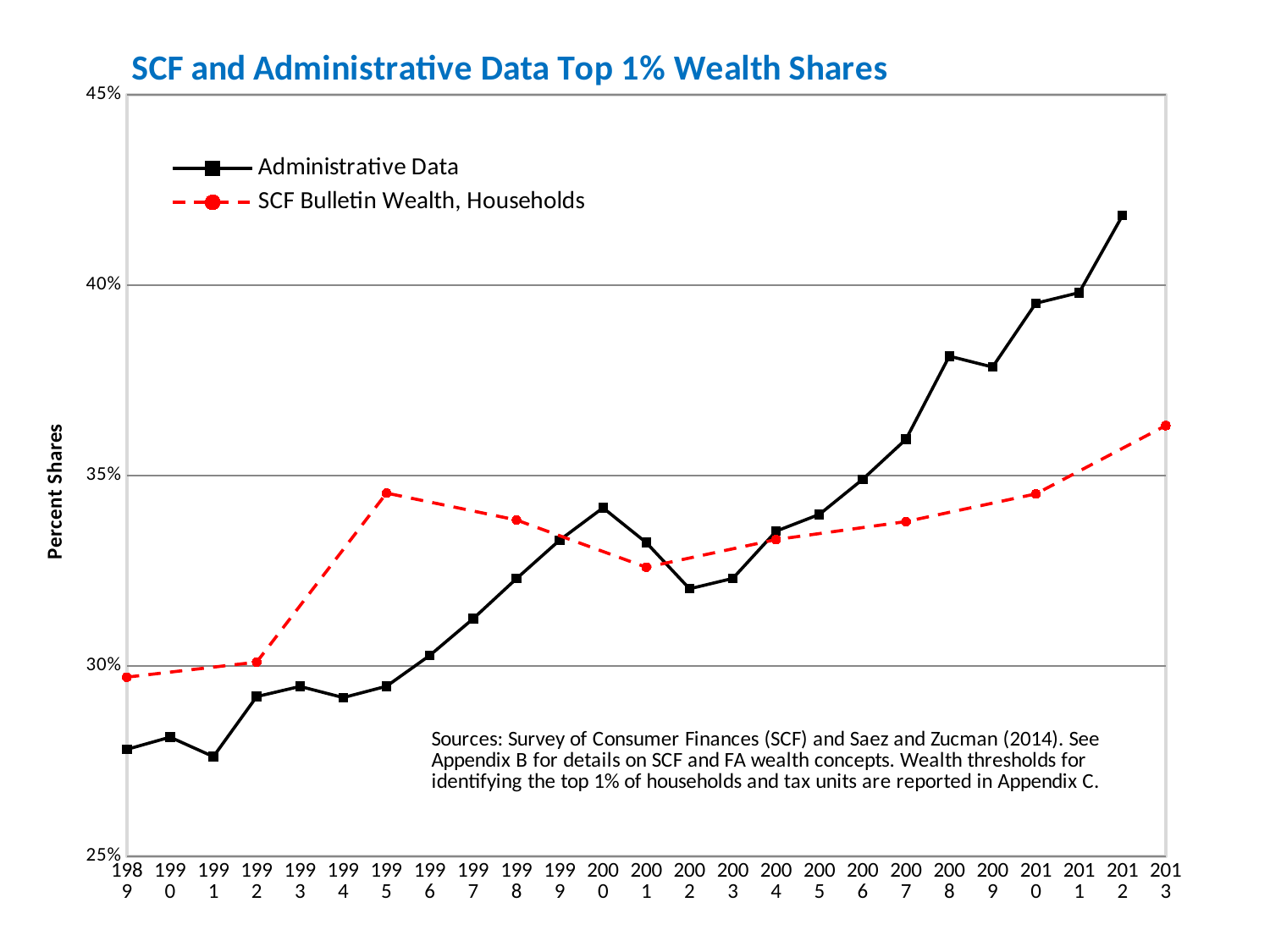
Does the Administrative Data series generally rise or fall from 1989 to 2013? Rise In 1995, which series has the larger value, Administrative Data or SCF Bulletin Wealth, Households? SCF Bulletin Wealth, Households In which year does the SCF Bulletin Wealth, Households series reach its lowest value? 1989 In which year does the Administrative Data series reach its highest value? 2012 What type of chart is shown on the slide? Line chart Is the SCF Bulletin Wealth, Households value for 2013 greater or less than 35%? greater Which series is drawn with a red dashed line? SCF Bulletin Wealth, Households Is the Administrative Data value for 1989 greater or less than 30%? less What is the title of the chart? SCF and Administrative Data Top 1% Wealth Shares Is the Administrative Data value for 2012 greater or less than 40%? greater How many years are shown on the x axis? 25 How many series does the legend list? 2